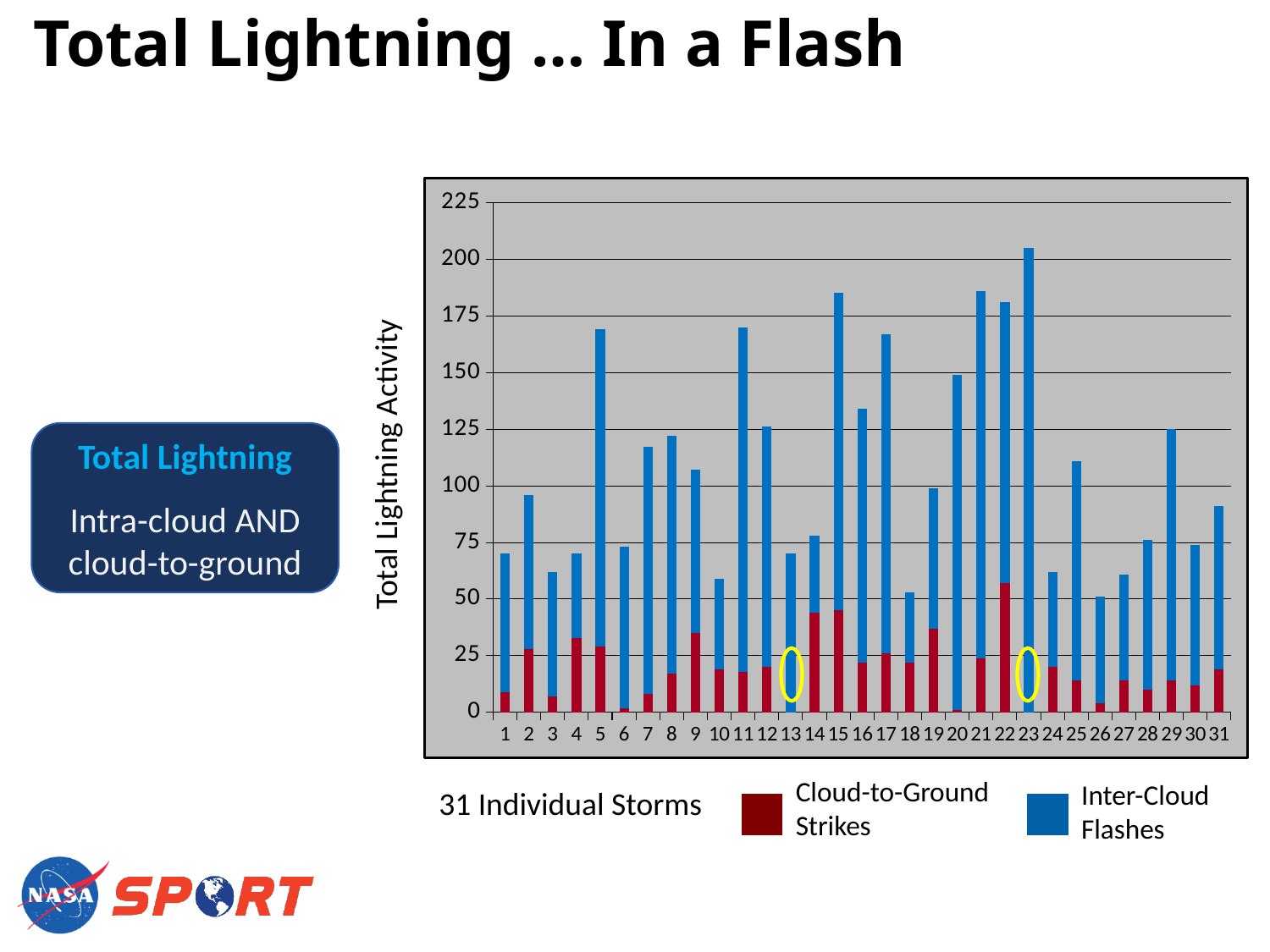
Is the total lightning activity for storm 20 greater or less than 125? greater What kind of chart is shown on the slide? bar chart Is the total lightning activity for storm 26 greater or less than 75? less Is the total lightning activity for storm 5 greater or less than 150? greater Which storm has the highest total lightning activity? 23 How many individual storms are plotted along the x axis of the chart? 31 Which storm has the higher total lightning activity, storm 5 or storm 7? storm 5 Which storm has the higher total lightning activity, storm 23 or storm 15? storm 23 How many series does the chart's legend list? 2 What are the two series named in the chart's legend? Cloud-to-Ground Strikes and Inter-Cloud Flashes